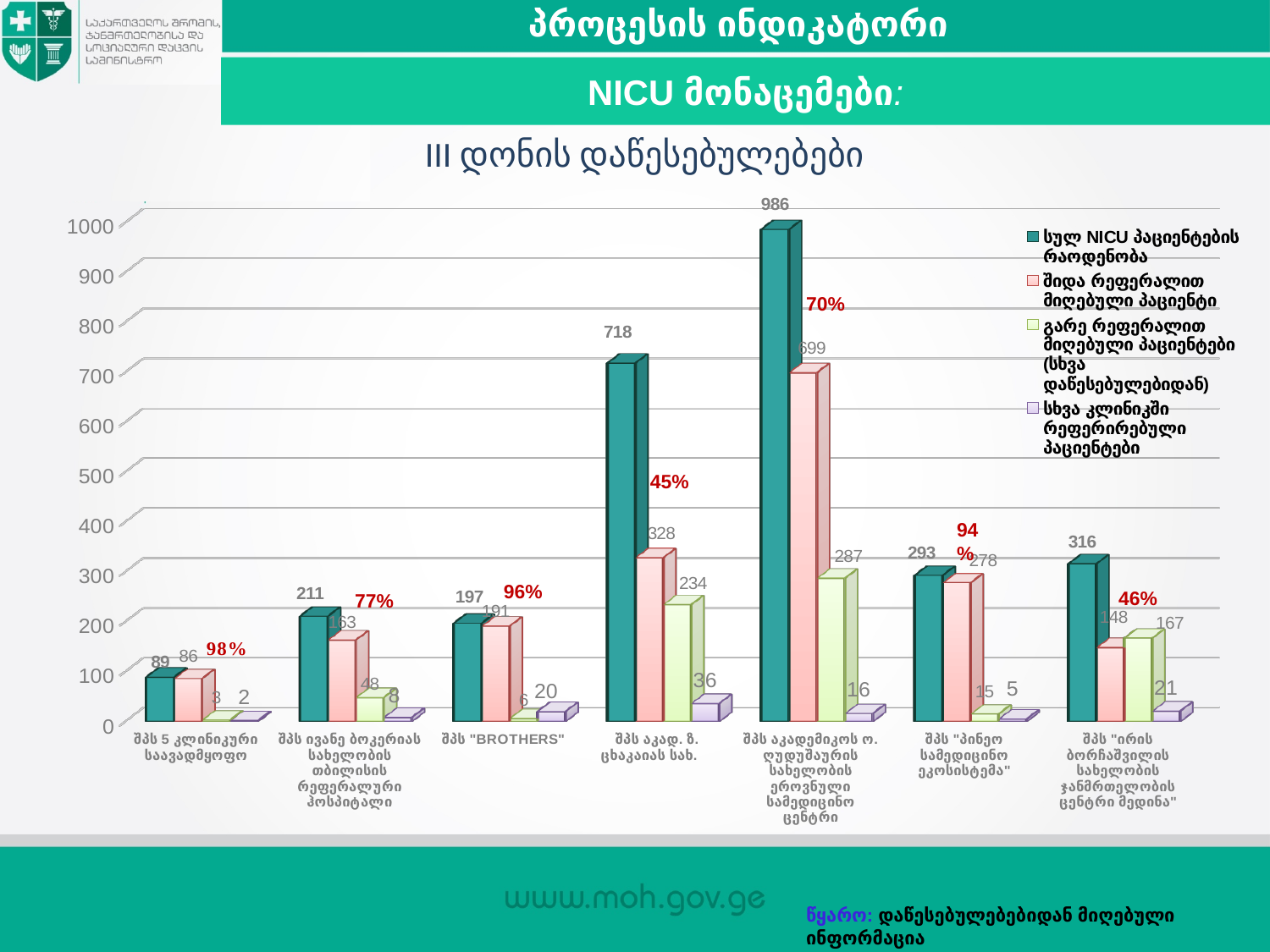
What is the value of სულ NICU პაციენტების რაოდენობა for შპს "BROTHERS"? 197 Is the value of სულ NICU პაციენტების რაოდენობა for შპს აკად. ზ. ცხაკაიას სახ. greater or less than 600? greater What is the difference between სულ NICU პაციენტების რაოდენობა and შიდა რეფერალით მიღებული პაციენტი for შპს "პინეო სამედიცინო ეკოსისტემა"? 15 Which institution has the lowest value for სულ NICU პაციენტების რაოდენობა? შპს 5 კლინიკური საავადმყოფო What percentage label is shown above the bars for შპს "BROTHERS"? 96% What is the value of შიდა რეფერალით მიღებული პაციენტი for შპს აკად. ზ. ცხაკაიას სახ.? 328 What is the title of the chart? III დონის დაწესებულებები What type of chart is shown on the slide? bar chart Which institution has the highest value for სულ NICU პაციენტების რაოდენობა? შპს აკადემიკოს ო. ღუდუშაურის სახელობის ეროვნული სამედიცინო ცენტრი Which is larger for შპს "ირის ბორჩაშვილის სახელობის ჯანმრთელობის ცენტრი მედინა": შიდა რეფერალით მიღებული პაციენტი or გარე რეფერალით მიღებული პაციენტები? გარე რეფერალით მიღებული პაციენტები How many categories (institutions) are shown on the x axis? 7 How many series does the legend list? 4